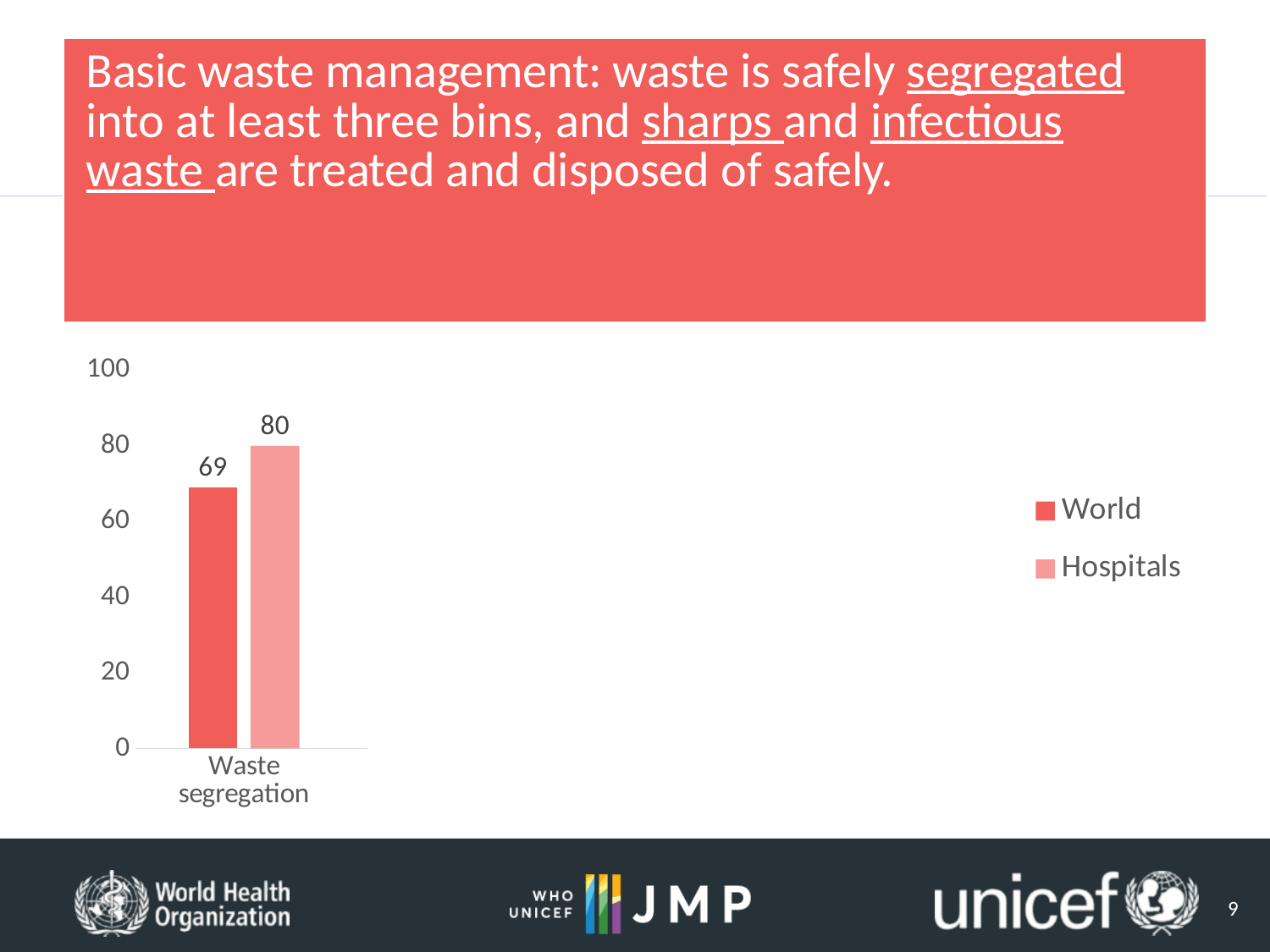
What is the difference between the Hospitals value and the World value for Waste segregation? 11 How many categories are shown on the x axis? 1 Which series is shown in the lighter pink colour? Hospitals What is the value for Hospitals in the Waste segregation category? 80 What is the value for World in the Waste segregation category? 69 Which series has the higher value for Waste segregation, World or Hospitals? Hospitals What is the label of the category on the x axis? Waste segregation What kind of chart is shown on the slide? Bar chart What is the maximum value shown on the y axis? 100 Is the value for World in Waste segregation greater or less than 60? greater Is the value for Hospitals in Waste segregation greater or less than 100? less How many series does the legend list? 2